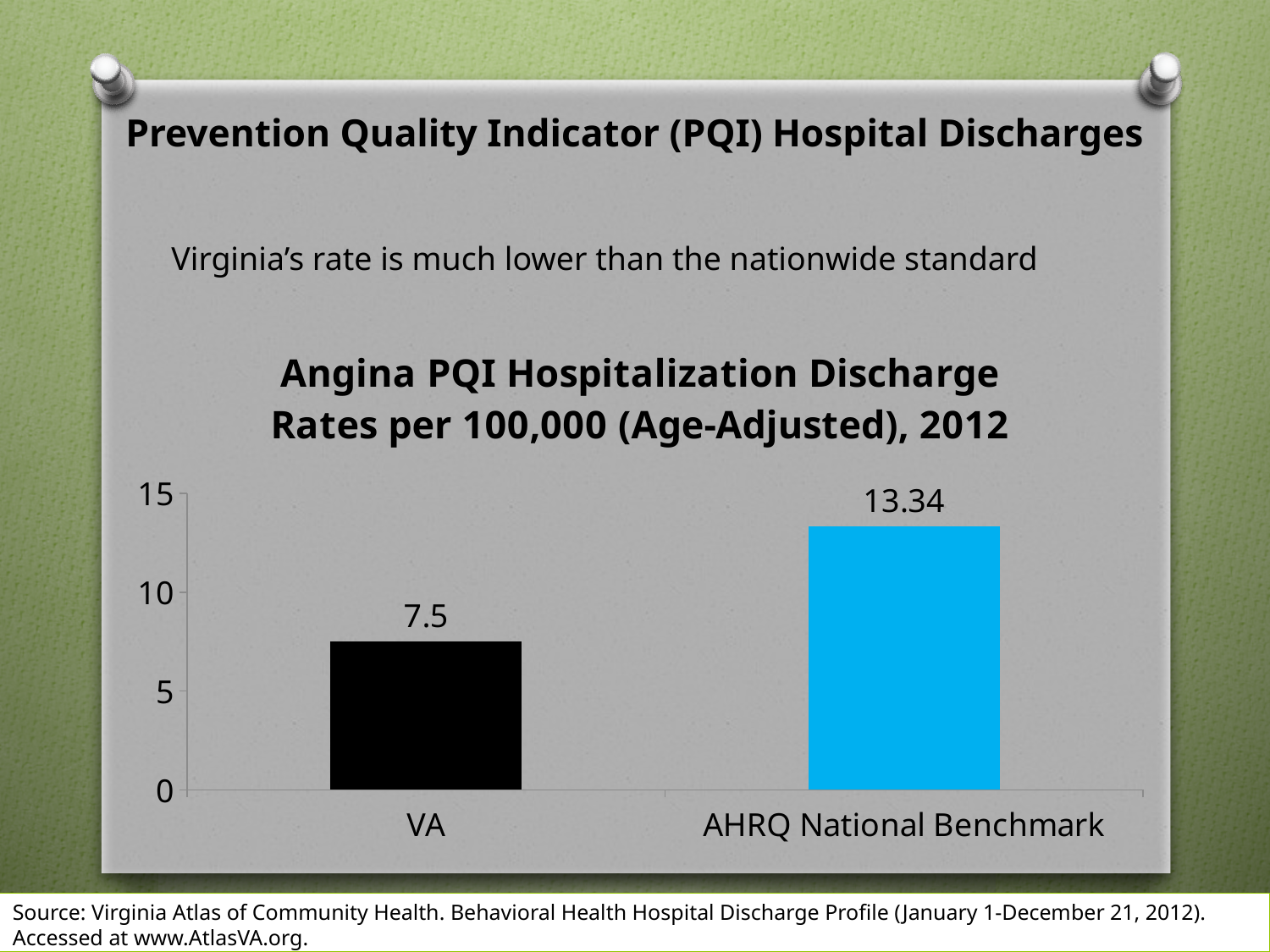
What is the difference between the AHRQ National Benchmark rate and the VA rate? 5.84 What is the Angina PQI hospitalization discharge rate for the AHRQ National Benchmark? 13.34 What colour is the bar for the AHRQ National Benchmark? blue Is the value for VA greater or less than 10? less What is the Angina PQI hospitalization discharge rate for VA? 7.5 How many categories are shown on the chart? 2 What is the title of the chart? Angina PQI Hospitalization Discharge Rates per 100,000 (Age-Adjusted), 2012 What kind of chart is shown on the slide? bar chart Which category has the higher discharge rate, VA or AHRQ National Benchmark? AHRQ National Benchmark Is the value for AHRQ National Benchmark greater or less than 10? greater Which category has the lowest discharge rate? VA Is the VA rate larger or smaller than the AHRQ National Benchmark rate? smaller